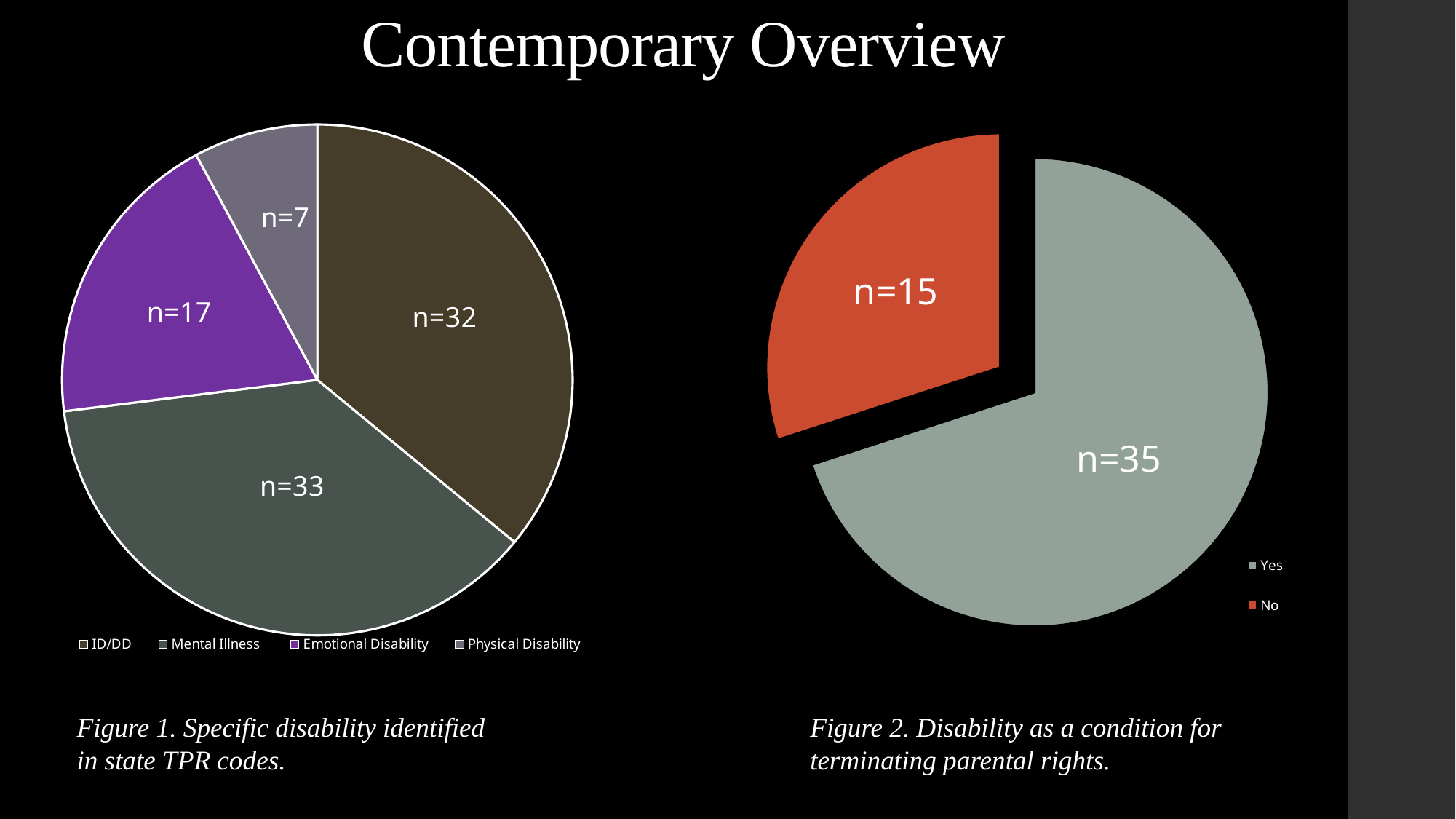
In Figure 2 (right pie chart), what share of the total does the Yes slice represent? 70% In Figure 1 (left pie chart), what is the value for Physical Disability? n=7 In Figure 2 (right pie chart), what is the value for Yes? n=35 In Figure 1 (left pie chart), how many categories does the legend list? 4 In Figure 1 (left pie chart), what is the value for Mental Illness? n=33 In Figure 1 (left pie chart), which category has the smallest slice? Physical Disability In Figure 1 (left pie chart), what is the difference between the values for ID/DD and Emotional Disability? 15 In Figure 1 (left pie chart), what is the value for Emotional Disability? n=17 In Figure 1 (left pie chart), which category has the largest value? Mental Illness What kind of chart is Figure 2 (right chart)? Pie chart In Figure 2 (right pie chart), what is the value for No? n=15 In Figure 2 (right pie chart), which is larger, Yes or No? Yes